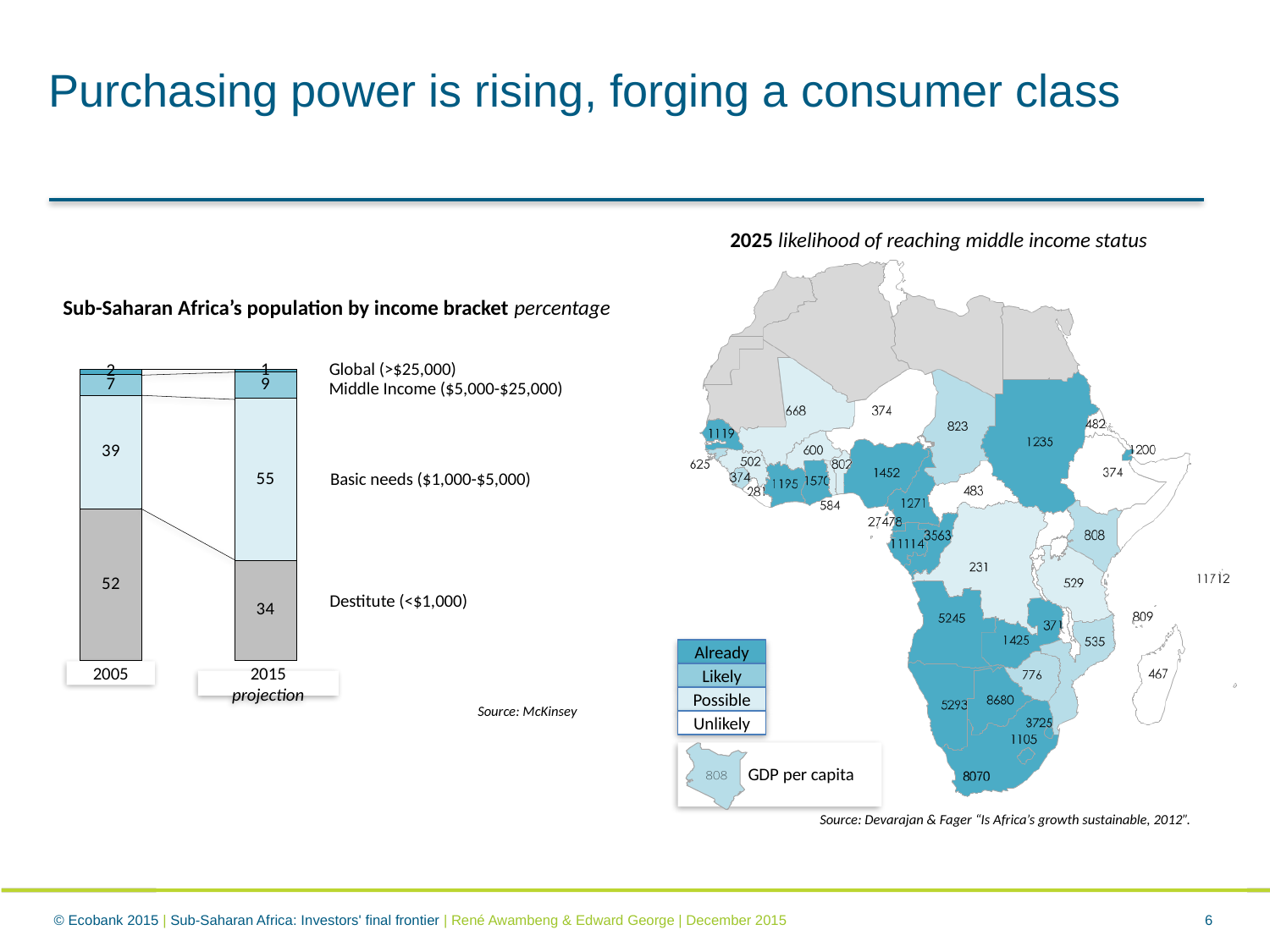
In the Sub-Saharan Africa's population by income bracket chart, by how many percentage points does the Destitute share fall from 2005 to the 2015 projection? 18 In the Sub-Saharan Africa's population by income bracket chart, by how many percentage points does the Basic needs share rise from 2005 to the 2015 projection? 16 What kind of chart is the Sub-Saharan Africa's population by income bracket chart? Stacked bar chart In the Sub-Saharan Africa's population by income bracket chart, what percentage is projected to be in the Basic needs ($1,000-$5,000) bracket in 2015? 55 In the Sub-Saharan Africa's population by income bracket chart, what percentage of the population was Destitute (<$1,000) in 2005? 52 In the Sub-Saharan Africa's population by income bracket chart, how many income brackets are shown in each stacked bar? 4 In the Sub-Saharan Africa's population by income bracket chart, what percentage is projected to be Global (>$25,000) in 2015? 1 What is the source given for the Sub-Saharan Africa's population by income bracket chart? McKinsey In the Sub-Saharan Africa's population by income bracket chart, which income bracket is the largest in the 2015 projection? Basic needs ($1,000-$5,000) In the Sub-Saharan Africa's population by income bracket chart, which year has the larger Middle Income share, 2005 or 2015? 2015 In the Sub-Saharan Africa's population by income bracket chart, what percentage was Middle Income ($5,000-$25,000) in 2005? 7 In the Sub-Saharan Africa's population by income bracket chart, which income bracket is the largest in 2005? Destitute (<$1,000)